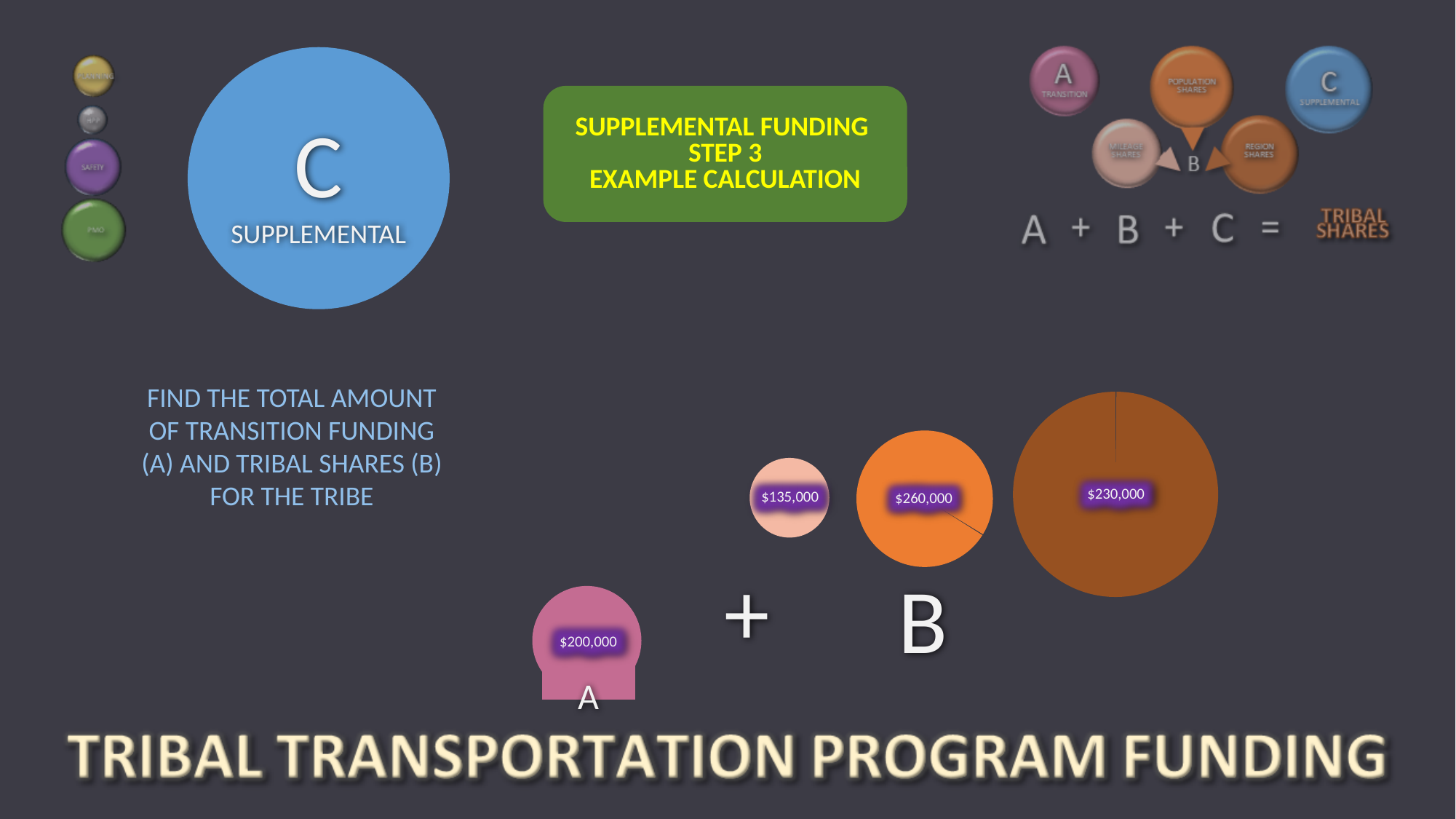
What is the total of the three values shown in the circles above B? $625,000 What is the difference between the orange circle's value and the peach circle's value? $125,000 Which of the three circles above B shows the lowest value? the peach circle ($135,000) What is the title in the green box at the top of the slide? SUPPLEMENTAL FUNDING STEP 3 EXAMPLE CALCULATION What value is printed in the small peach circle above B? $135,000 What is the total of the A value and the three B values shown on the slide? $825,000 How many circles on the slide have a dollar value printed on them? 4 What value is printed in the pink circle labelled A? $200,000 What value is printed in the orange circle above B? $260,000 Which shows a larger value, the orange circle or the brown circle? the orange circle Which of the three circles above B shows the highest value? the orange circle ($260,000) What value is printed in the large brown circle above B? $230,000